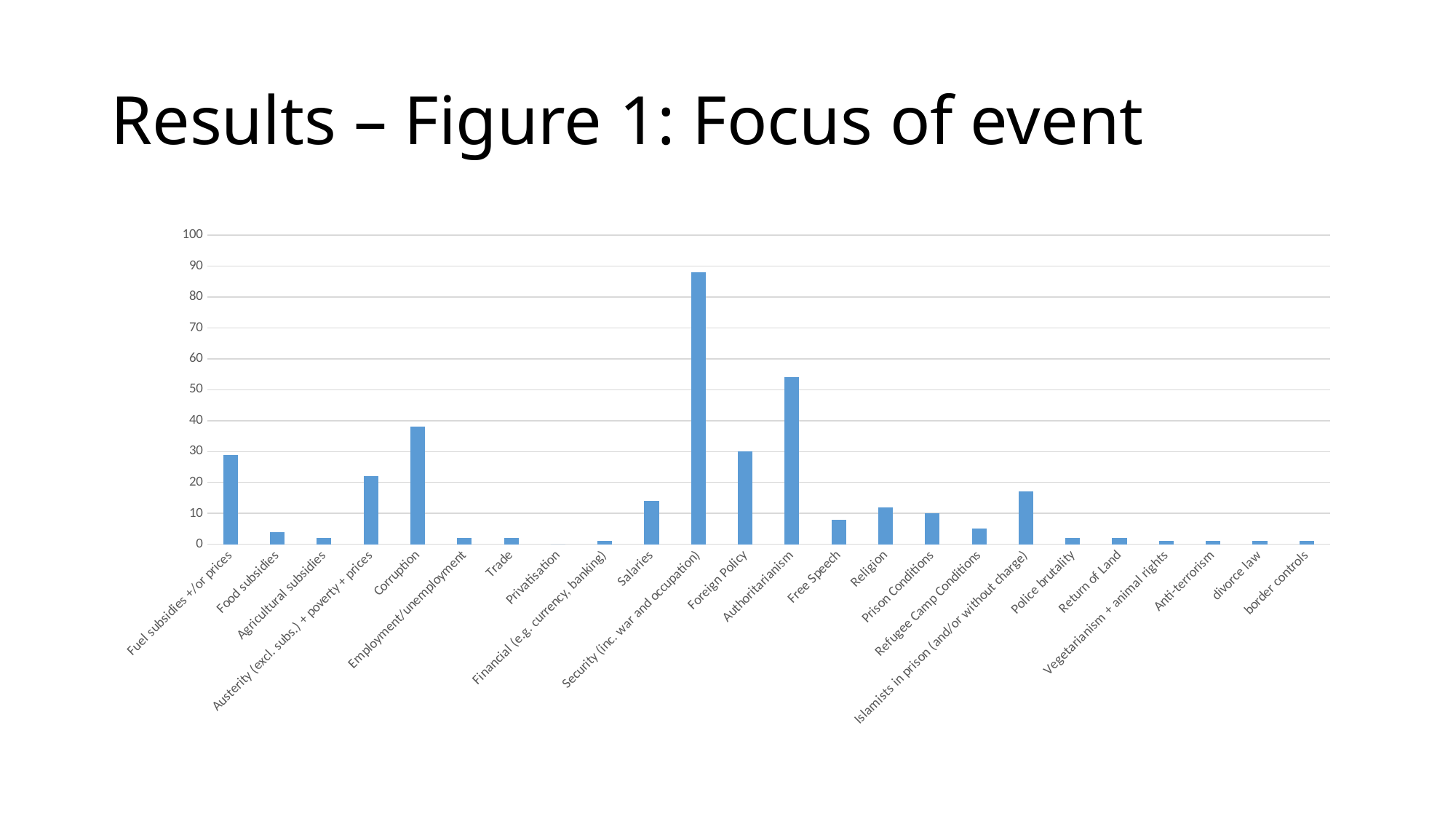
What is the value for Foreign Policy? 30 Is the value for Corruption greater or less than 40? less Which is larger, the value for Fuel subsidies +/or prices or the value for Salaries? Fuel subsidies +/or prices Which is larger, the value for Authoritarianism or the value for Corruption? Authoritarianism What kind of chart is shown on the slide? bar chart Is the value for Security (inc. war and occupation) greater or less than 80? greater What is the title of the slide? Results – Figure 1: Focus of event How many categories are shown on the x axis? 24 Is the value for Authoritarianism greater or less than 50? greater Which category has the lowest value? Privatisation Which category has the highest value? Security (inc. war and occupation)